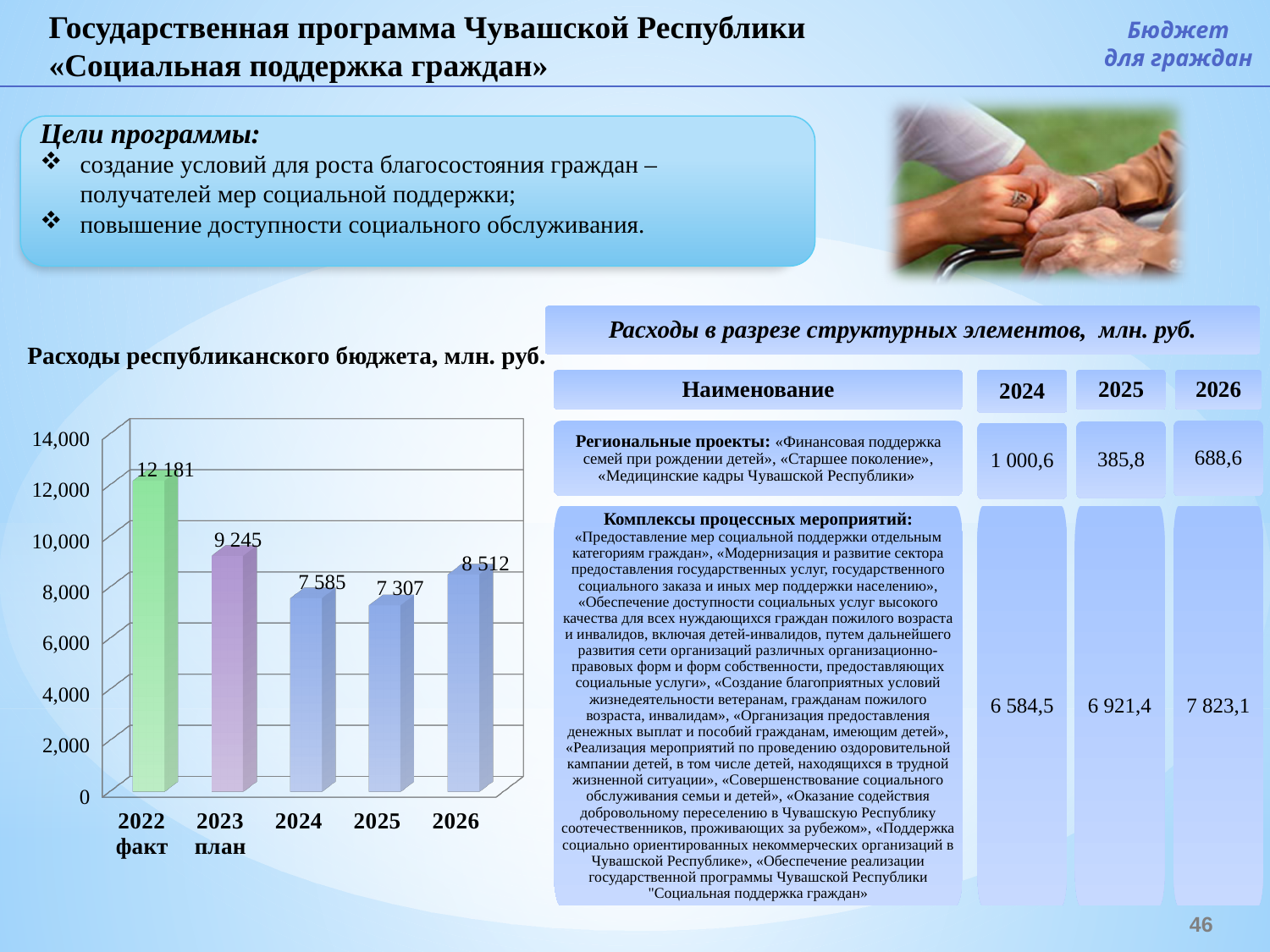
How many years (bars) are shown in the chart 'Расходы республиканского бюджета, млн. руб.'? 5 Which year has the lowest value in the chart 'Расходы республиканского бюджета, млн. руб.'? 2025 What is the value for 2022 (факт) in the chart 'Расходы республиканского бюджета, млн. руб.'? 12 181 In the chart 'Расходы республиканского бюджета, млн. руб.', what is the difference between the values for 2026 and 2025? 1 205 In the chart 'Расходы республиканского бюджета, млн. руб.', do the values rise or fall from 2022 to 2025? fall What is the value for 2026 in the chart 'Расходы республиканского бюджета, млн. руб.'? 8 512 In the chart 'Расходы республиканского бюджета, млн. руб.', is the value for 2023 greater or less than 10,000? less Which year has the highest value in the chart 'Расходы республиканского бюджета, млн. руб.'? 2022 In the chart 'Расходы республиканского бюджета, млн. руб.', which is larger: the value for 2024 or the value for 2026? 2026 What is the value for 2025 in the chart 'Расходы республиканского бюджета, млн. руб.'? 7 307 In the chart 'Расходы республиканского бюджета, млн. руб.', what is the difference between the values for 2022 and 2023? 2 936 What kind of chart is 'Расходы республиканского бюджета, млн. руб.'? bar chart